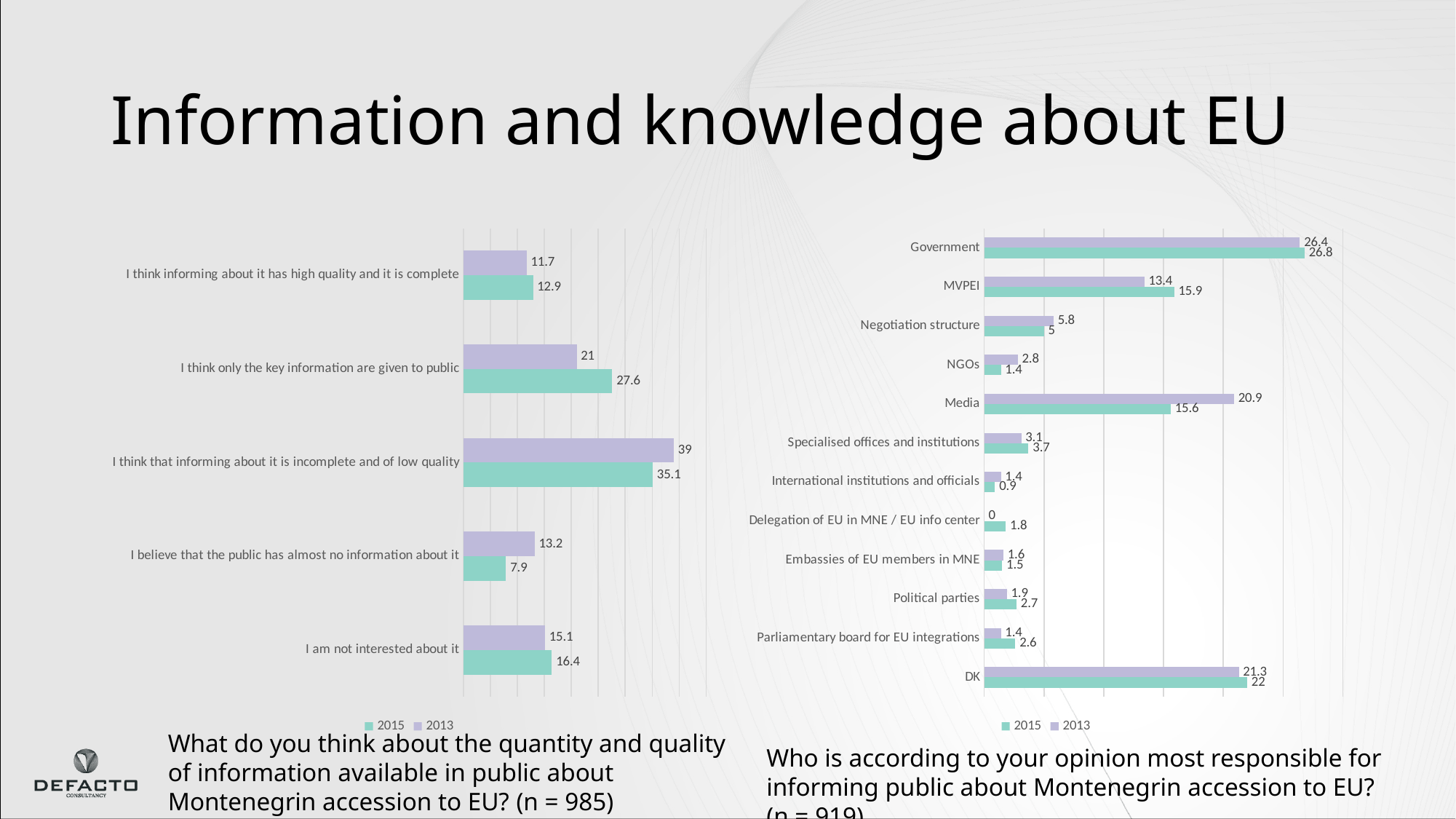
In the right chart, what is the 2015 value for MVPEI? 15.9 In the left chart, what is the 2013 value for "I believe that the public has almost no information about it"? 13.2 In the right chart, which category has the lowest 2013 value? Delegation of EU in MNE / EU info center In the right chart, what is the 2013 value for Media? 20.9 In the right chart, how many categories are listed? 12 In the left chart, which category has the highest 2013 value? I think that informing about it is incomplete and of low quality In the left chart, what is the 2015 value for "I think only the key information are given to public"? 27.6 What type of chart is the left chart? Bar chart In the right chart, which is larger for NGOs: the 2013 value or the 2015 value? 2013 How many series does the legend of the right chart list? 2 In the left chart, what is the difference between the 2013 and 2015 values for "I think that informing about it is incomplete and of low quality"? 3.9 In the left chart, how many categories are shown? 5